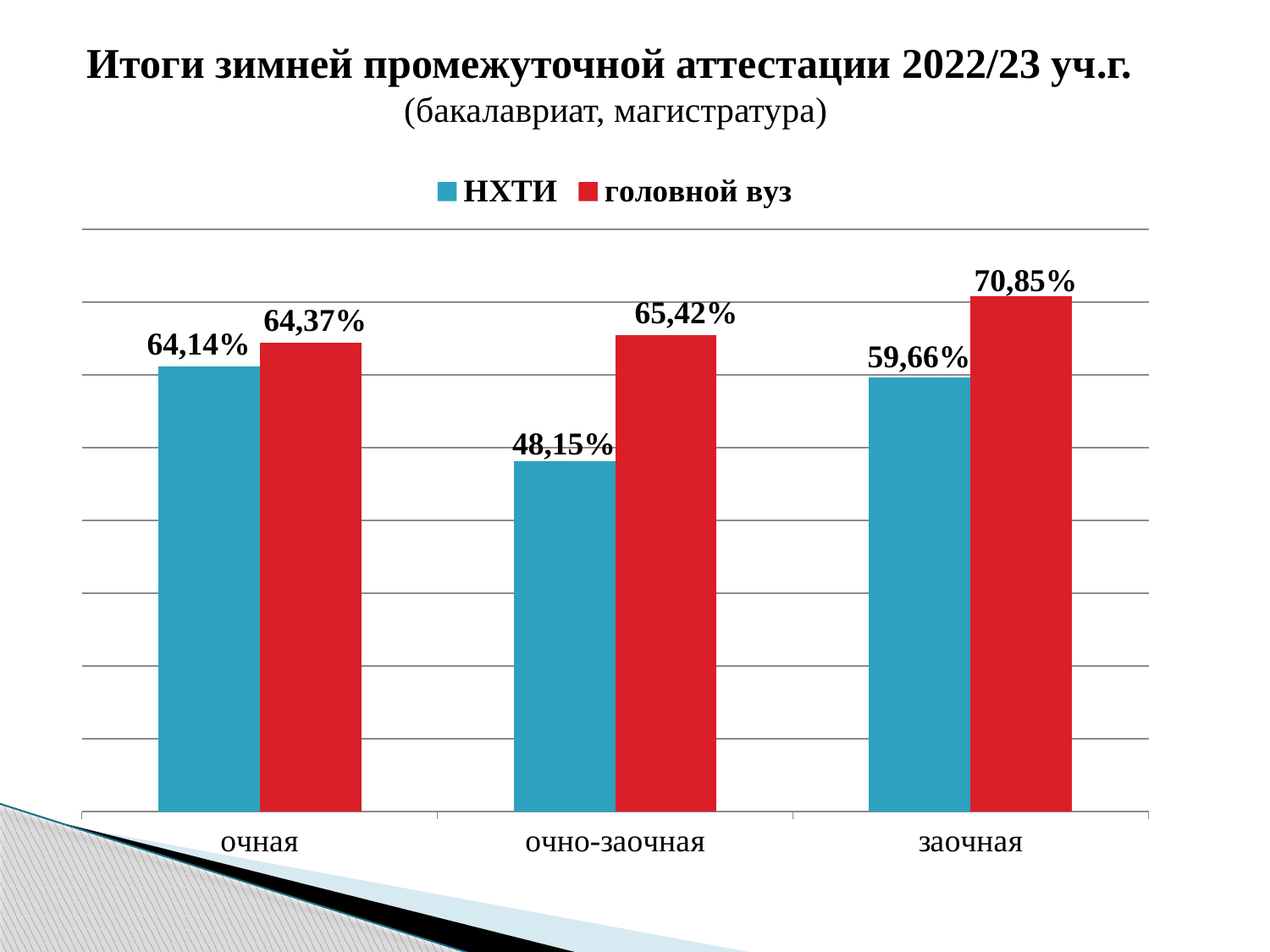
How many categories are shown on the x axis? 3 What is the difference between головной вуз and НХТИ in the заочная category? 11,19% What is the value for головной вуз in the очно-заочная category? 65,42% In the заочная category, which series has the larger value, НХТИ or головной вуз? головной вуз What kind of chart is shown on the slide? bar chart What is the value for головной вуз in the заочная category? 70,85% Which category has the lowest value for НХТИ? очно-заочная How many series does the legend list? 2 Which category has the highest value for головной вуз? заочная What is the difference between головной вуз and НХТИ in the очно-заочная category? 17,27% What is the value for НХТИ in the очно-заочная category? 48,15% What is the value for НХТИ in the очная category? 64,14%